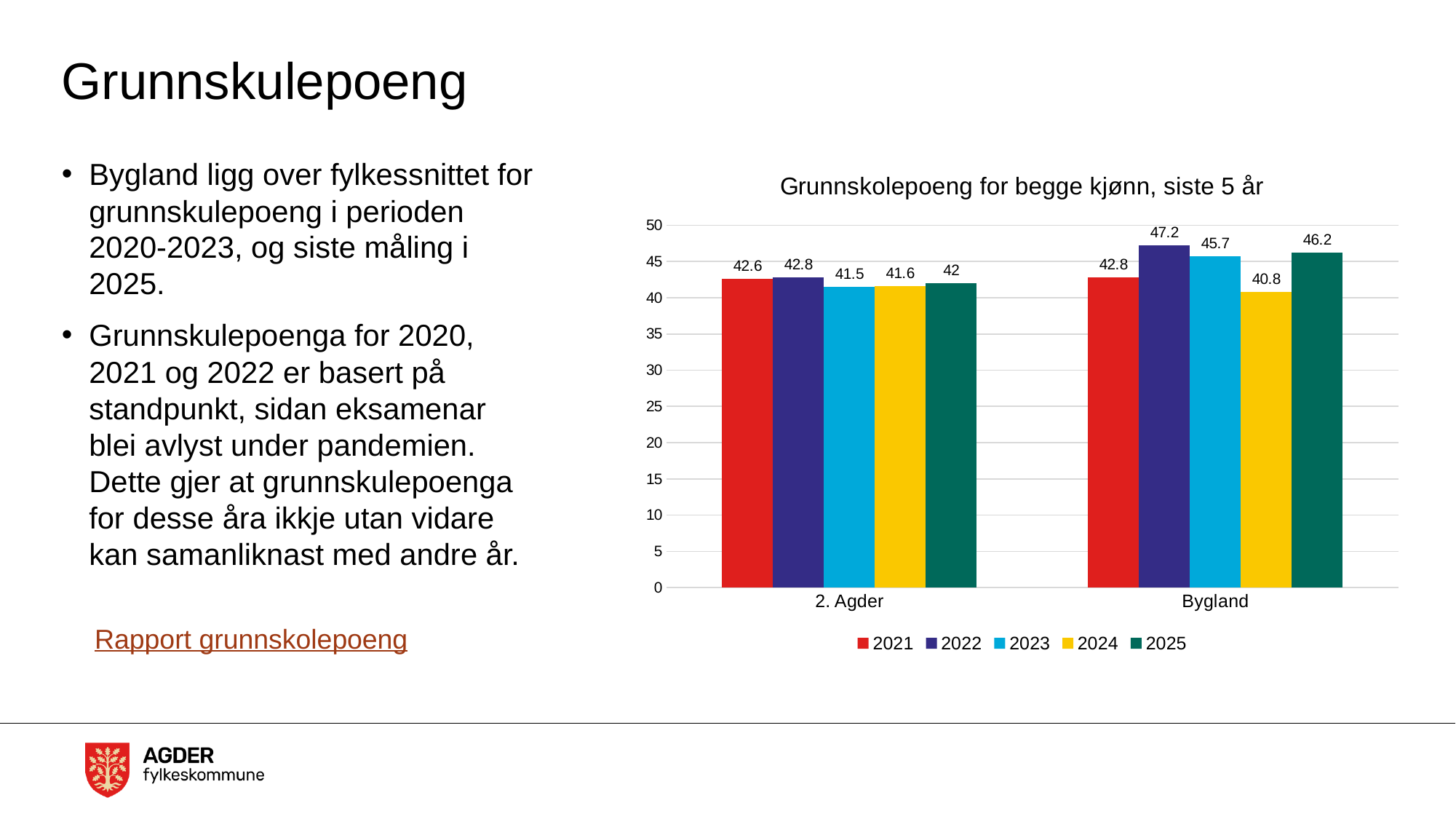
What is the value for 2. Agder in 2023? 41.5 What kind of chart is shown? Bar chart How many series does the legend list? 5 What is the value for Bygland in 2024? 40.8 Which year has the lowest value for Bygland? 2024 What is the title of the chart? Grunnskolepoeng for begge kjønn, siste 5 år Which year has the highest value for Bygland? 2022 What is the difference between Bygland and 2. Agder in 2025? 4.2 What is the value for Bygland in 2022? 47.2 How many categories are shown on the x axis? 2 Which is larger in 2024: 2. Agder or Bygland? 2. Agder Is the value for Bygland in 2022 greater or less than 45? greater